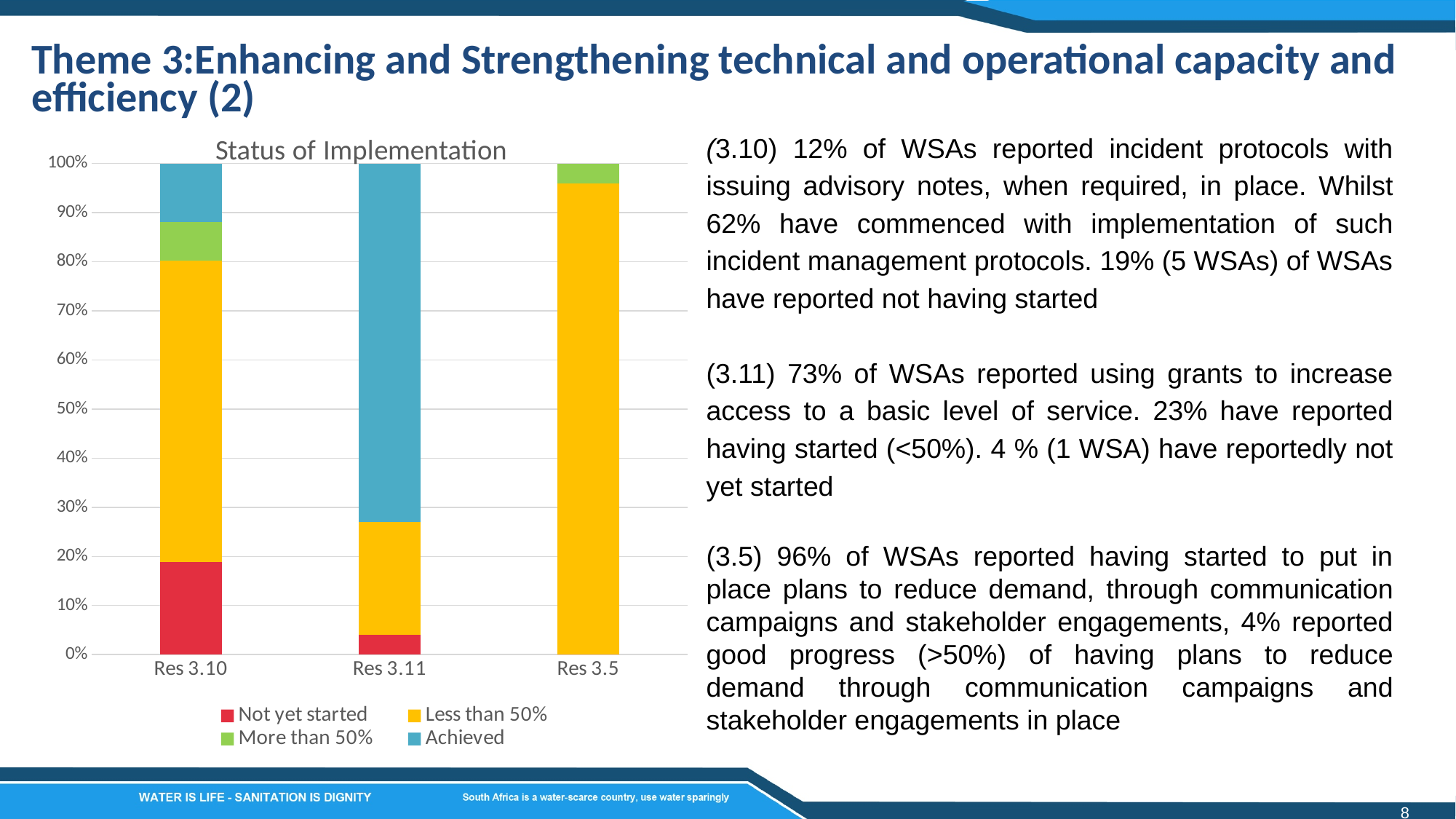
Which category has the largest 'Achieved' share? Res 3.11 Is the 'Not yet started' share for Res 3.11 greater or less than 10%? less Is the 'Achieved' share for Res 3.11 greater or less than 50%? greater What is the title of the chart? Status of Implementation Which colour represents the 'Achieved' series in the chart? Blue Which category has the largest 'Less than 50%' share? Res 3.5 How many series does the chart legend list? 4 How many categories are shown on the x axis of the chart? 3 Which category has the largest 'Not yet started' share? Res 3.10 Which is larger: the 'Achieved' share for Res 3.10 or for Res 3.11? Res 3.11 What type of chart is shown on the slide? Stacked bar chart Is the 'Less than 50%' share for Res 3.5 greater or less than 90%? greater